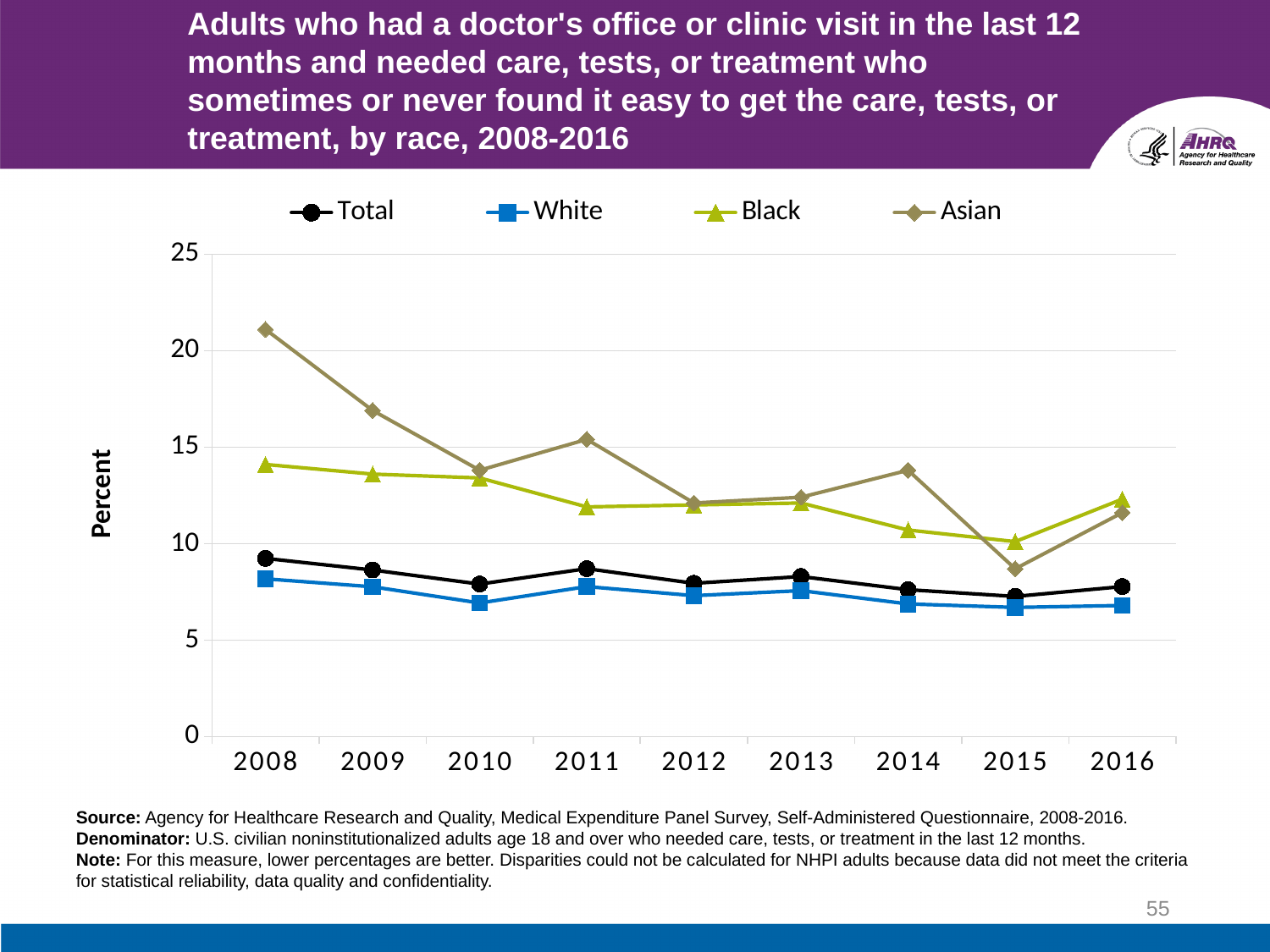
In 2008, which is larger, the value for Total or the value for White? Total Is the value for Asian in 2009 greater or less than 15? greater How many years are plotted along the x axis? 9 In 2014, which is larger, the value for Asian or the value for Black? Asian How many series does the legend list? 4 In which year is the value for Asian lowest? 2015 Is the value for Asian in 2008 greater or less than 20? greater What kind of chart is shown on the slide? line chart Does the value for Asian rise or fall from 2008 to 2010? fall What is the label on the y axis? Percent In which year is the value for Asian highest? 2008 Is the value for White in 2010 greater or less than 10? less